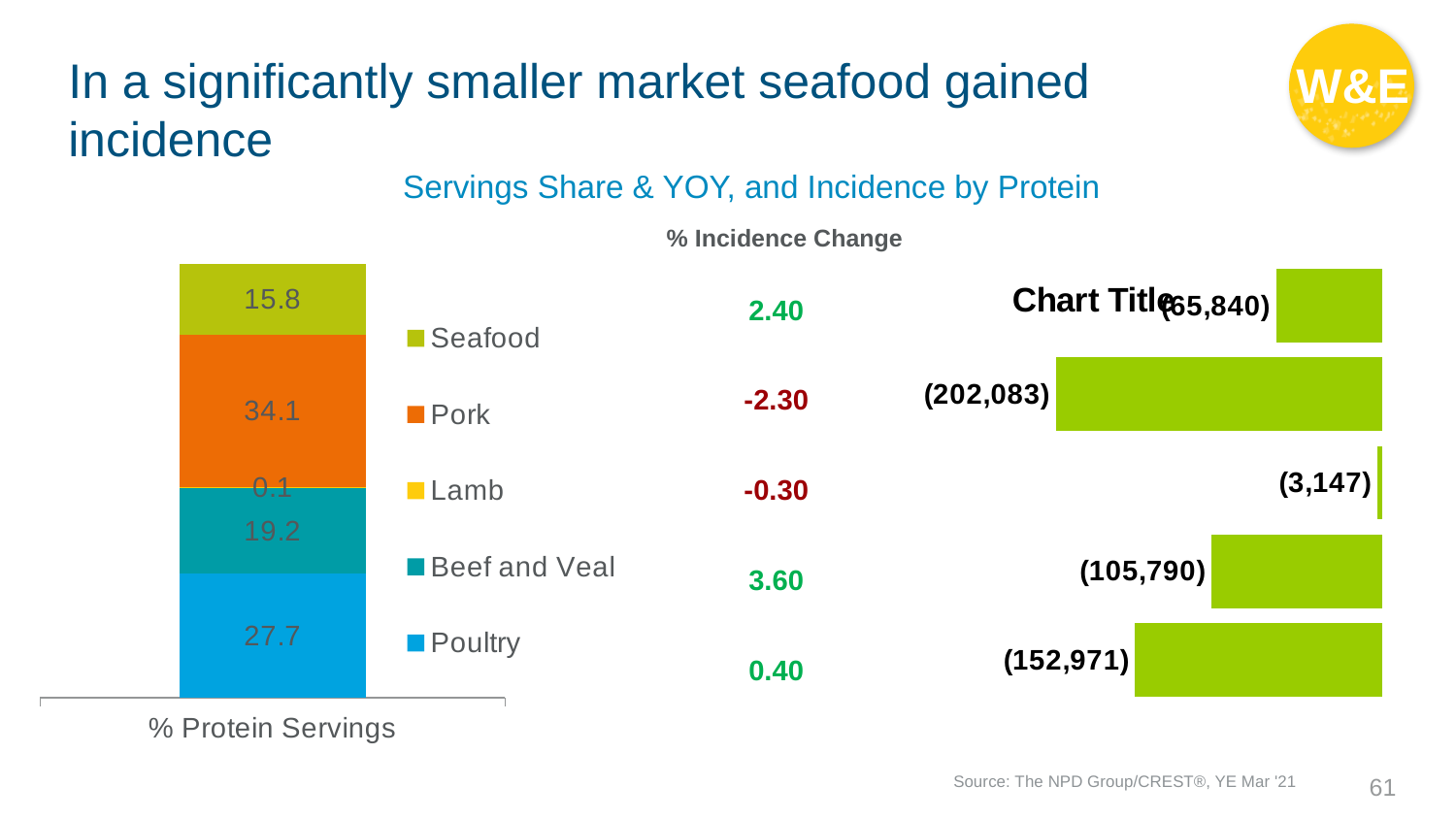
What kind of chart is the % Protein Servings chart on the left? Stacked bar chart In the % Protein Servings stacked bar chart, what is the value for Poultry? 27.7 In the % Protein Servings stacked bar chart, which protein has the smallest segment? Lamb In the % Protein Servings stacked bar chart, what is the total of all the segments? 96.9 In the % Protein Servings stacked bar chart, which protein has the largest segment? Pork In the % Protein Servings stacked bar chart, what is the value for Pork? 34.1 In the % Protein Servings stacked bar chart, which is larger: Poultry or Beef and Veal? Poultry What is the title shown on the chart on the right of the slide? Chart Title How many protein categories does the legend of the % Protein Servings chart list? 5 In the chart on the right of the slide, how many bars are plotted? 5 In the % Protein Servings stacked bar chart, what is the difference between the Pork and Seafood values? 18.3 In the chart on the right of the slide, what is the data label on the longest bar? (202,083)